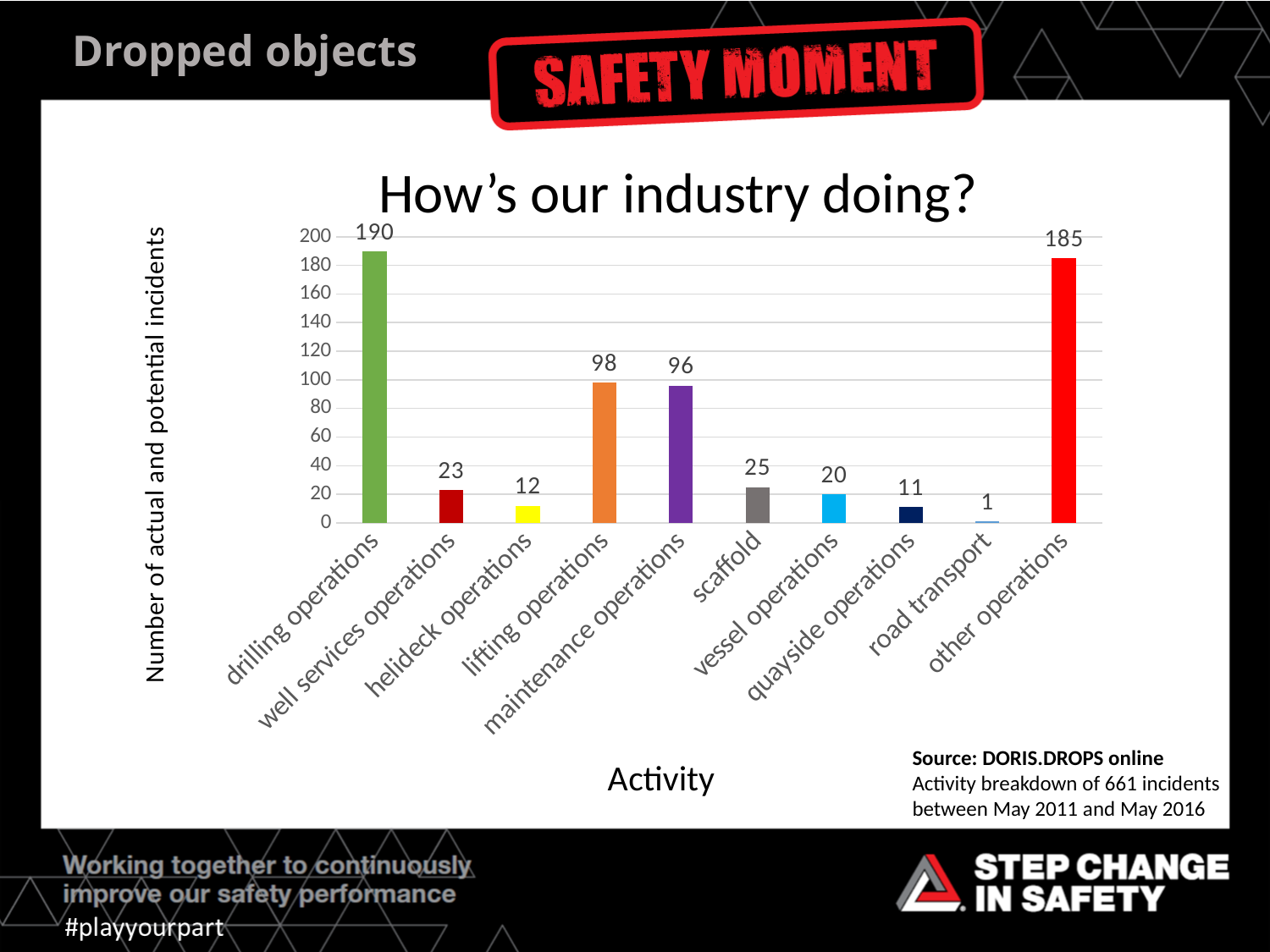
What is the difference between the values for lifting operations and maintenance operations? 2 What is the value shown for lifting operations? 98 What kind of chart is shown on the slide? bar chart Which has more incidents, scaffold or vessel operations? scaffold How many activity categories are shown on the x axis? 10 Which activity has the lowest number of incidents? road transport What is the difference between the values for drilling operations and other operations? 5 Which activity has the highest number of incidents? drilling operations What is the title of the chart? How's our industry doing? Is the value for other operations greater or less than 100? greater What is the number of actual and potential incidents for drilling operations? 190 What is the value shown for road transport? 1